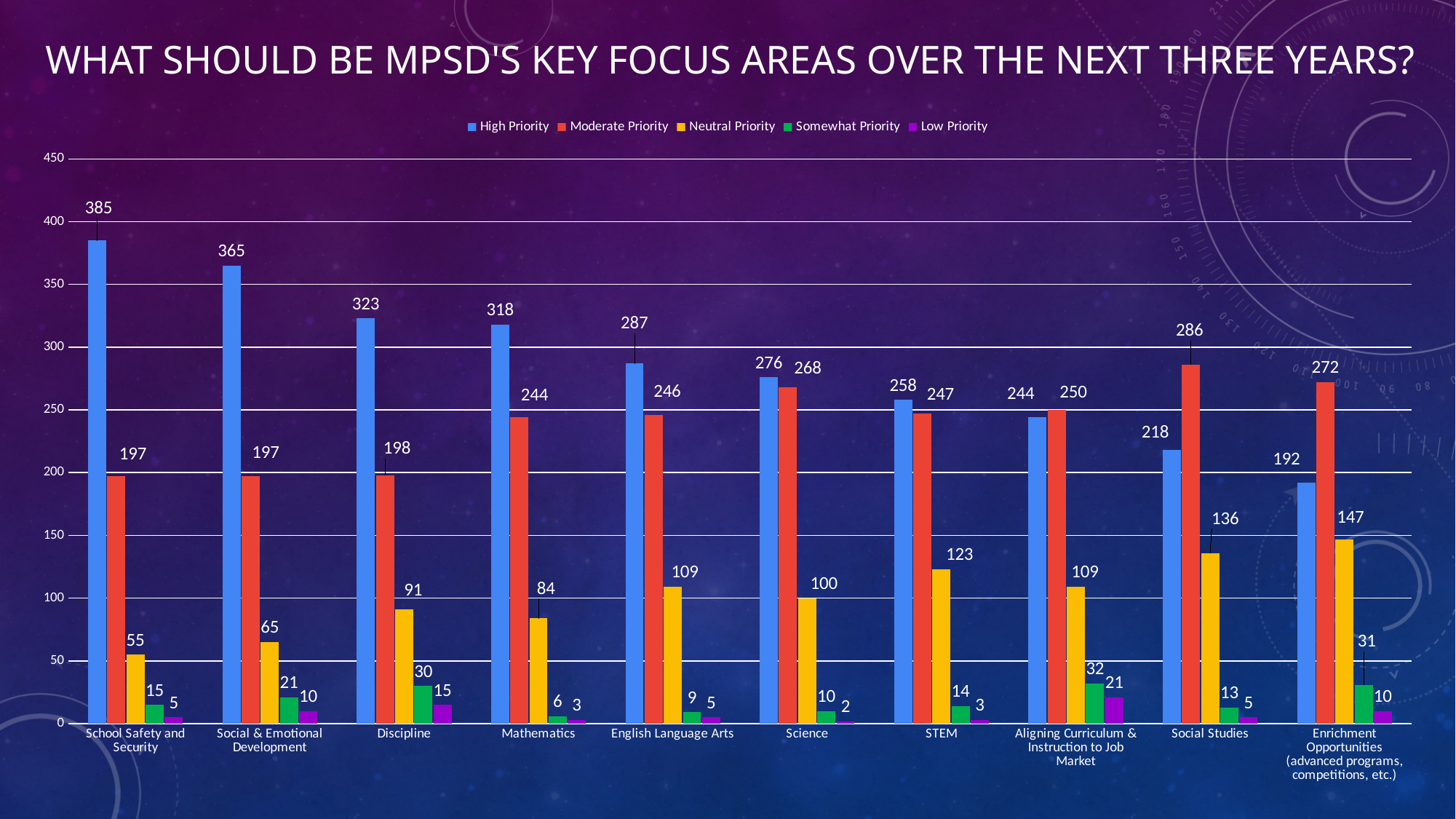
How many categories are shown on the x axis? 10 What is the difference between the High Priority and Moderate Priority values for Mathematics? 74 How many series does the legend list? 5 What is the Somewhat Priority value for Discipline? 30 Do the High Priority values rise or fall from left to right across the categories? Fall What is the Neutral Priority value for Enrichment Opportunities (advanced programs, competitions, etc.)? 147 Which category has the highest High Priority value? School Safety and Security What kind of chart is shown on the slide? Bar chart Which category has the lowest High Priority value? Enrichment Opportunities (advanced programs, competitions, etc.) What is the High Priority value for School Safety and Security? 385 What is the Moderate Priority value for Social Studies? 286 For Aligning Curriculum & Instruction to Job Market, which is larger: the High Priority value or the Moderate Priority value? Moderate Priority